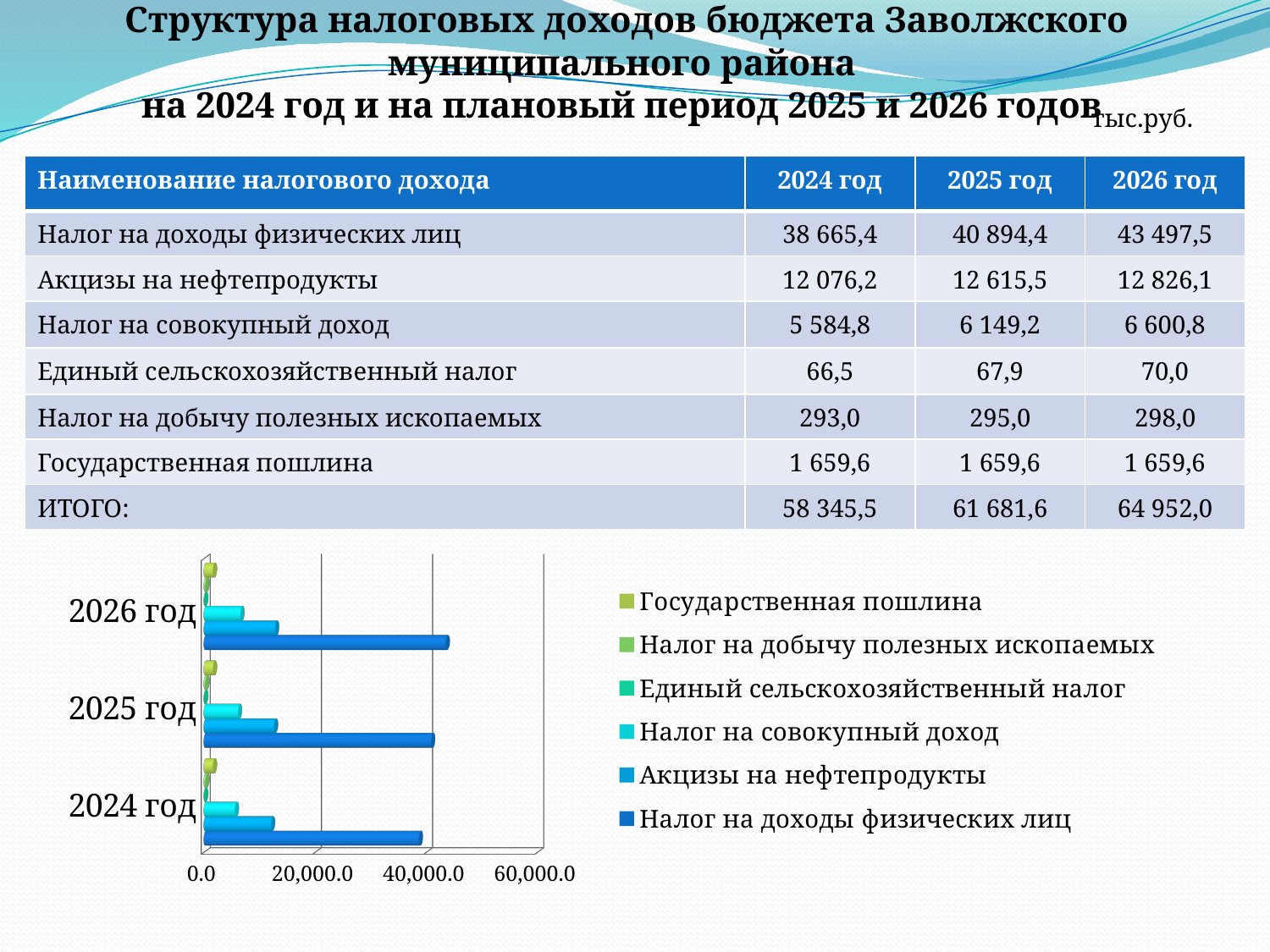
How many year categories does the chart show? 3 How many series does the chart legend list? 6 Is the value for Налог на доходы физических лиц in 2024 год greater or less than 40,000.0? less In 2024 год, which is larger: Налог на доходы физических лиц or Акцизы на нефтепродукты? Налог на доходы физических лиц What colour represents Налог на доходы физических лиц in the chart legend? dark blue Is the value for Акцизы на нефтепродукты in 2025 год greater or less than 20,000.0? less Which series is listed first in the chart legend? Государственная пошлина What is the value for Налог на доходы физических лиц in 2024 год, as printed in the table? 38 665,4 In which year is the bar for Налог на доходы физических лиц the longest? 2026 год Is the value for Налог на доходы физических лиц in 2026 год greater or less than 40,000.0? greater Does the bar for Налог на доходы физических лиц rise or fall from 2024 год to 2026 год? rises What kind of chart is shown on the slide? bar chart